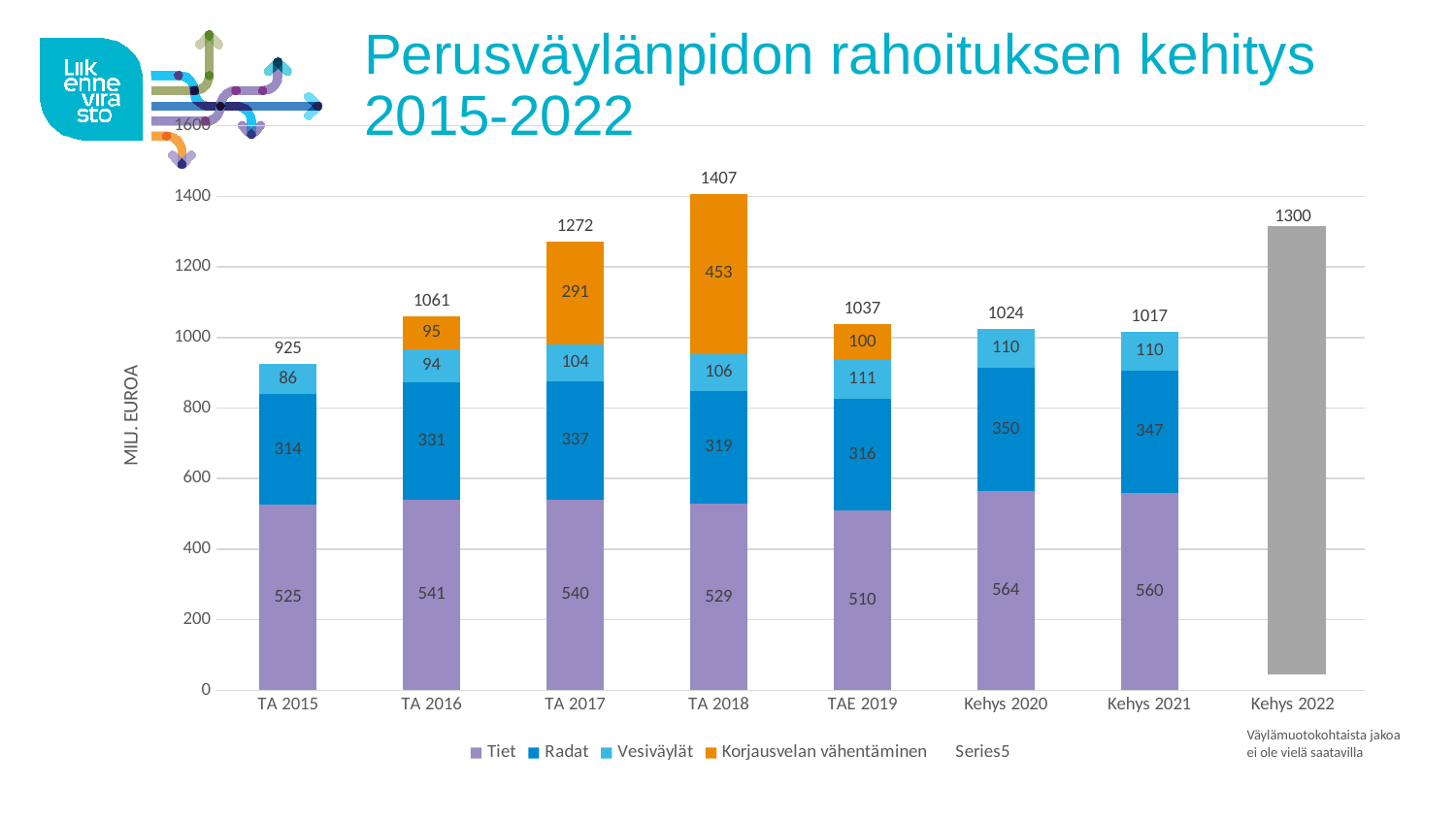
Which category has the lowest total value? TA 2015 Which category has the highest total value? TA 2018 How many series does the legend list? 5 What is the value of Tiet for TA 2016? 541 What is the difference between the totals for TA 2018 and TA 2017? 135 What kind of chart is shown on the slide? Stacked bar chart What is the total shown above the stacked bar for TA 2017? 1272 How many categories are shown on the x axis? 8 What is the value of Radat for Kehys 2020? 350 What is the value of Korjausvelan vähentäminen for TA 2018? 453 Which is larger, the Tiet value for Kehys 2020 or for Kehys 2021? Kehys 2020 What is the value of Vesiväylät for TAE 2019? 111